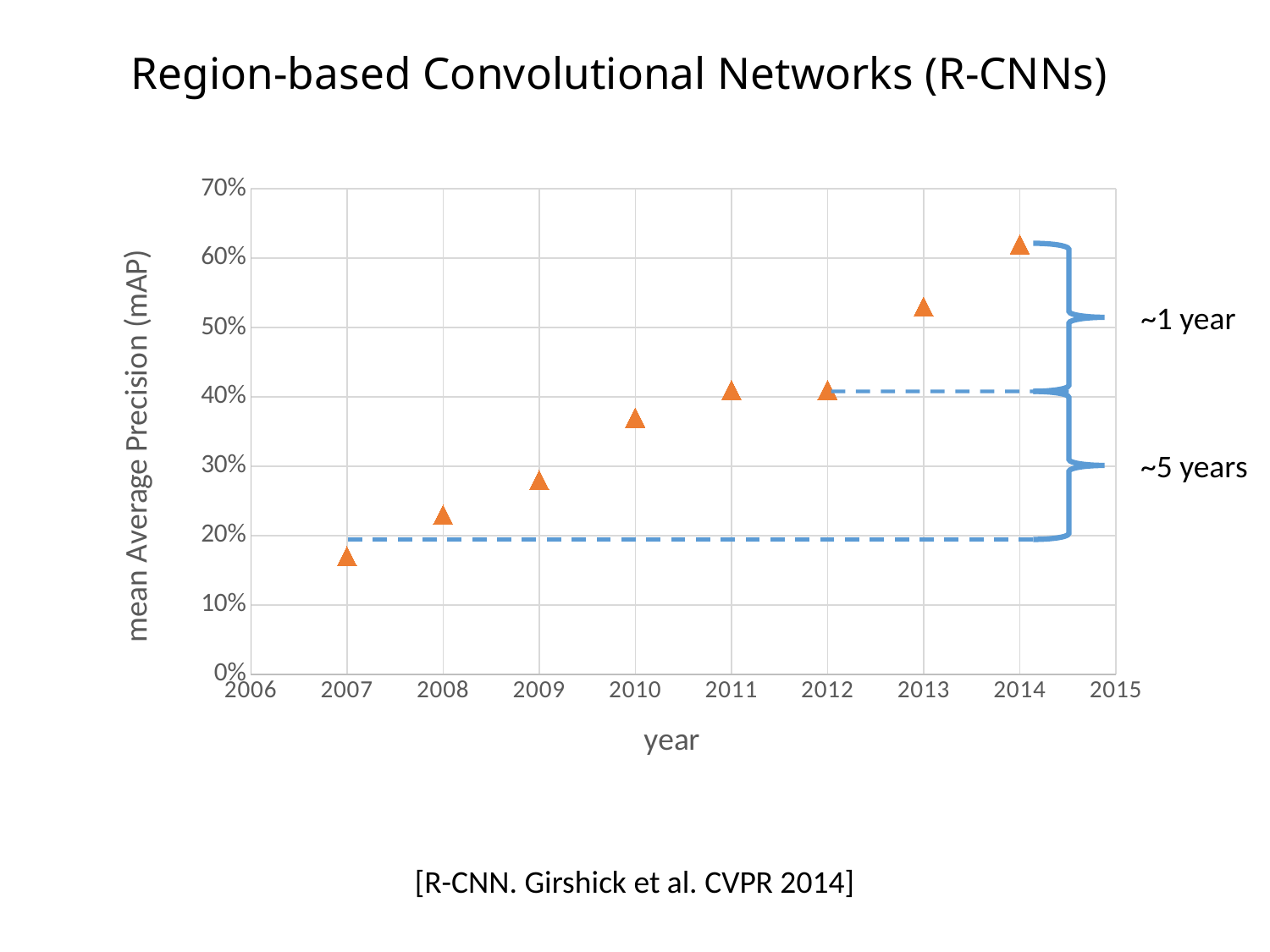
Which year has the highest mean Average Precision? 2014 Is the value for 2009 greater or less than 30%? less Is the value for 2014 greater or less than 60%? greater Is the value for 2010 greater or less than 30%? greater Which year has the lowest mean Average Precision? 2007 What is the label of the vertical axis? mean Average Precision (mAP) Which year has a higher mAP, 2010 or 2013? 2013 Do the mAP values generally rise or fall from 2007 to 2014? rise What kind of chart is shown on the slide? scatter chart How many data points are plotted on the chart? 8